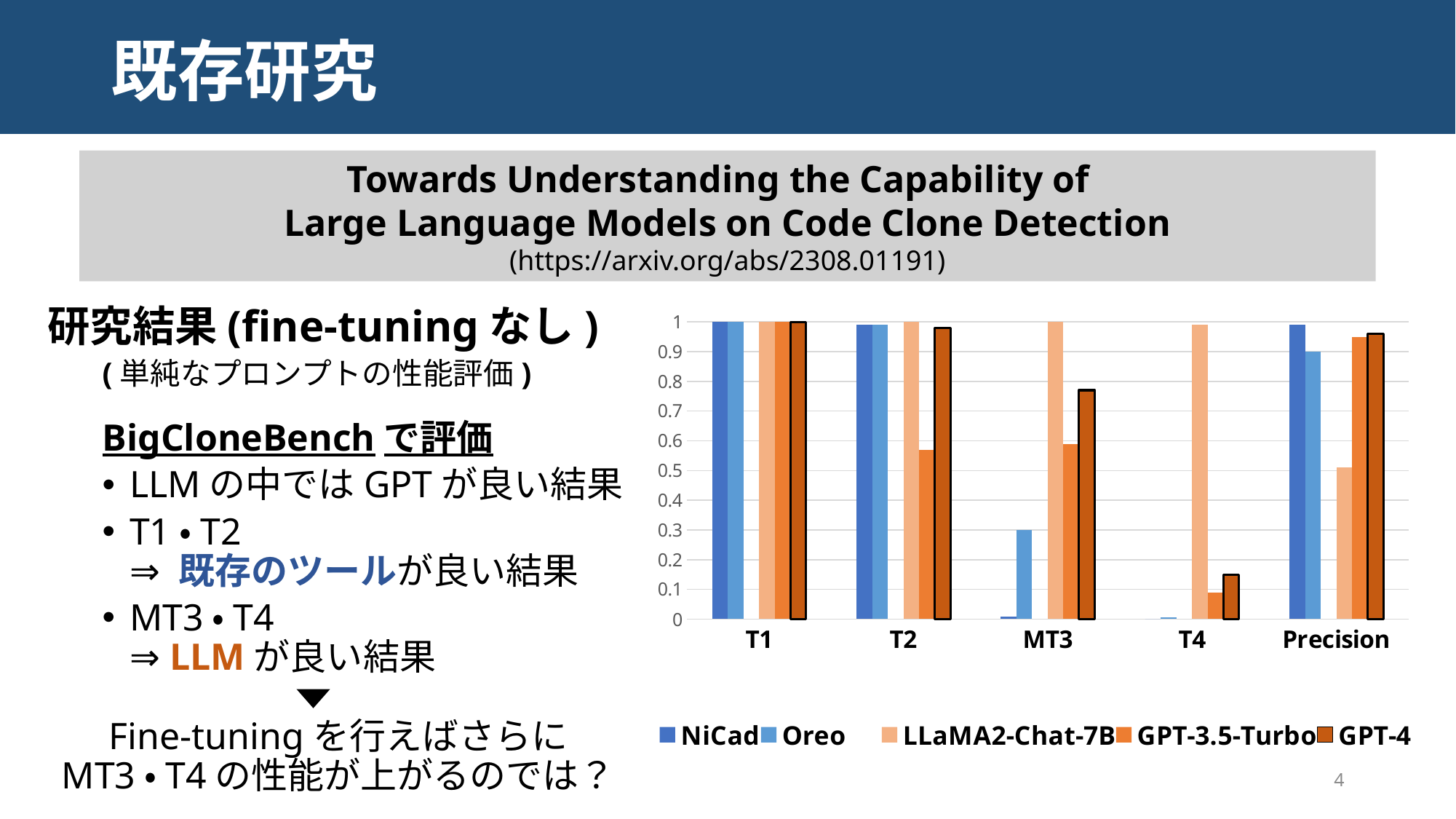
What is the value for LLaMA2-Chat-7B at MT3? 1 How many series does the chart's legend list? 5 Which series is drawn with a black outline in the chart? GPT-4 Is the value for GPT-3.5-Turbo at T2 greater or less than 0.5? greater At T2, which is larger: the value for GPT-4 or the value for GPT-3.5-Turbo? GPT-4 Which series has the highest value at T4? LLaMA2-Chat-7B What kind of chart is shown on the slide? bar chart Is the value for GPT-4 at T4 greater or less than 0.2? less Which series has the lowest value at Precision? LLaMA2-Chat-7B Is the value for GPT-4 at MT3 greater or less than 0.7? greater How many categories are shown on the x axis of the chart? 5 What is the value for Oreo at MT3? 0.3